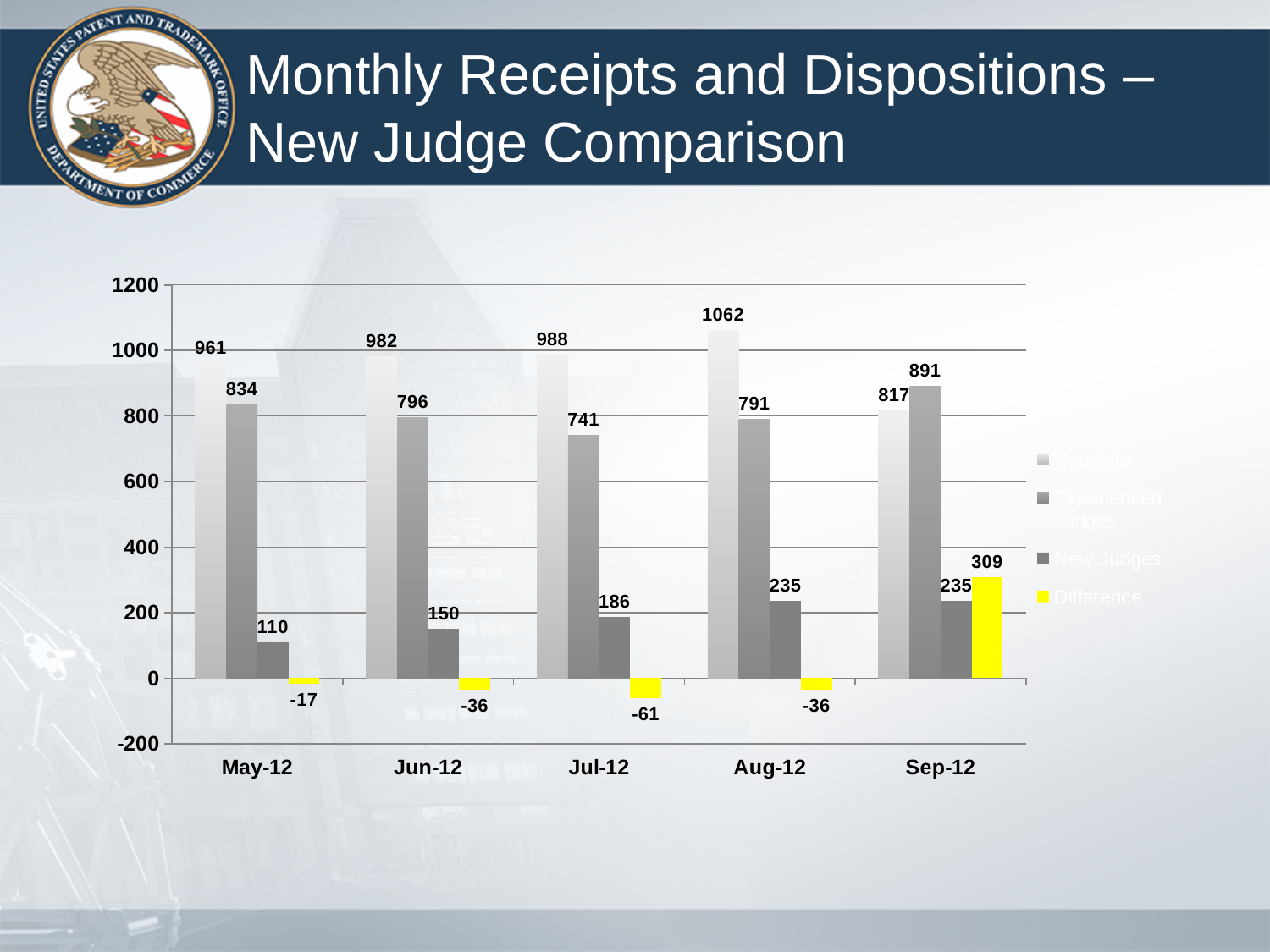
Which is larger in Sep-12, Receipts or Experienced Judges? Experienced Judges How many months are shown on the x axis? 5 What is the difference between Receipts and Experienced Judges in May-12? 127 In which month is the Difference value lowest? Jul-12 What is the value of Receipts for Aug-12? 1062 Do the New Judges values rise or fall from May-12 to Aug-12? Rise What is the value of Difference for Sep-12? 309 In which month are Receipts highest? Aug-12 What is the value of New Judges for Jun-12? 150 What kind of chart is shown on the slide? Bar chart How many series does the legend list? 4 What is the value of Experienced Judges for Jul-12? 741